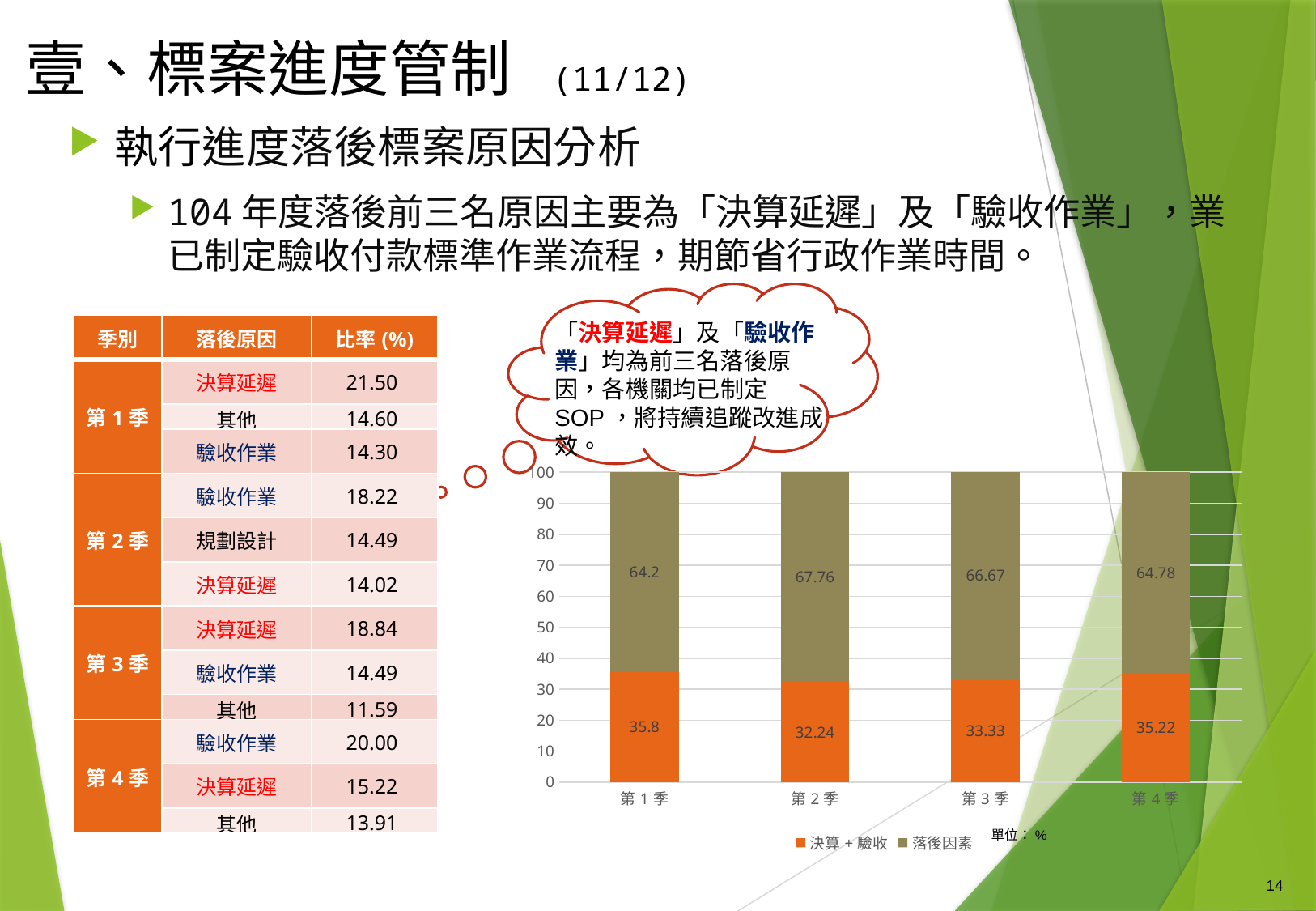
What is the total of the stacked bar for 第 3 季? 100 What is the value of 決算＋驗收 for 第 3 季? 33.33 What kind of chart is shown on the slide? stacked bar chart How many quarters (categories) are plotted on the x axis of the chart? 4 What is the value of 決算＋驗收 for 第 1 季? 35.8 Which quarter has the lowest value for 決算＋驗收? 第 2 季 How many series does the chart legend list? 2 What is the difference between the 落後因素 values for 第 2 季 and 第 1 季? 3.56 Which is larger: the 決算＋驗收 value for 第 4 季 or for 第 3 季? 第 4 季 What is the value of 落後因素 for 第 2 季? 67.76 Which quarter has the highest value for 決算＋驗收? 第 1 季 What is the value of 落後因素 for 第 4 季? 64.78